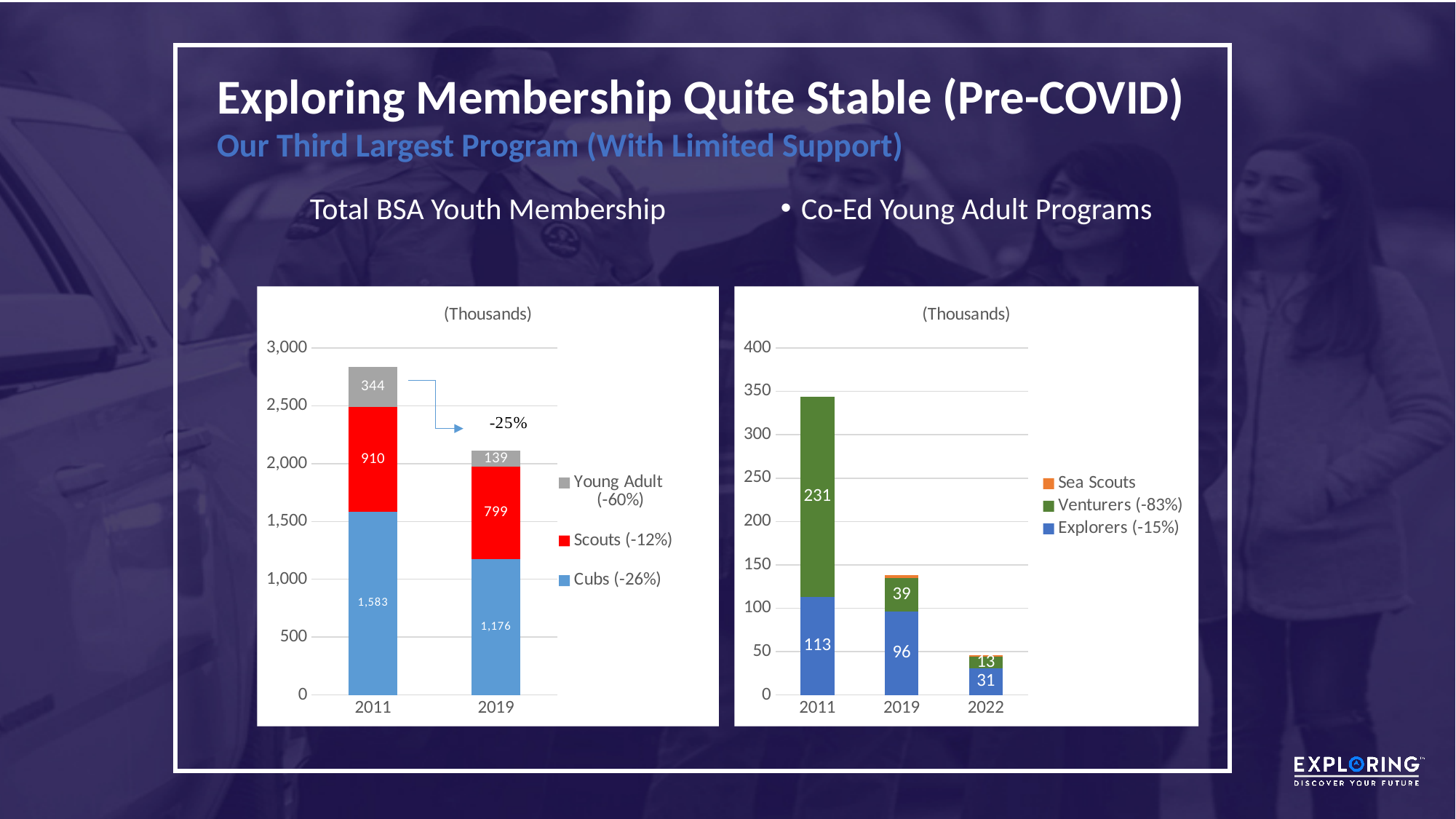
In the Total BSA Youth Membership chart, what is the value for Scouts in 2019? 799 In the Total BSA Youth Membership chart, how many series does the legend list? 3 In the Co-Ed Young Adult Programs chart, is the total for 2019 greater or less than 150? less In the Total BSA Youth Membership chart, what is the total of the stacked bar for 2019? 2,114 In the Total BSA Youth Membership chart, what is the value for Cubs in 2011? 1,583 In the Co-Ed Young Adult Programs chart, what is the value for Venturers in 2011? 231 In the Co-Ed Young Adult Programs chart, how many years are shown on the x axis? 3 What kind of chart is the Co-Ed Young Adult Programs chart? Stacked bar chart In the Total BSA Youth Membership chart, what is the value for Young Adult in 2011? 344 In the Co-Ed Young Adult Programs chart, what is the value for Explorers in 2022? 31 In the Co-Ed Young Adult Programs chart, which year has the lowest Explorers value? 2022 In the Total BSA Youth Membership chart, what is the difference between the Cubs values for 2011 and 2019? 407